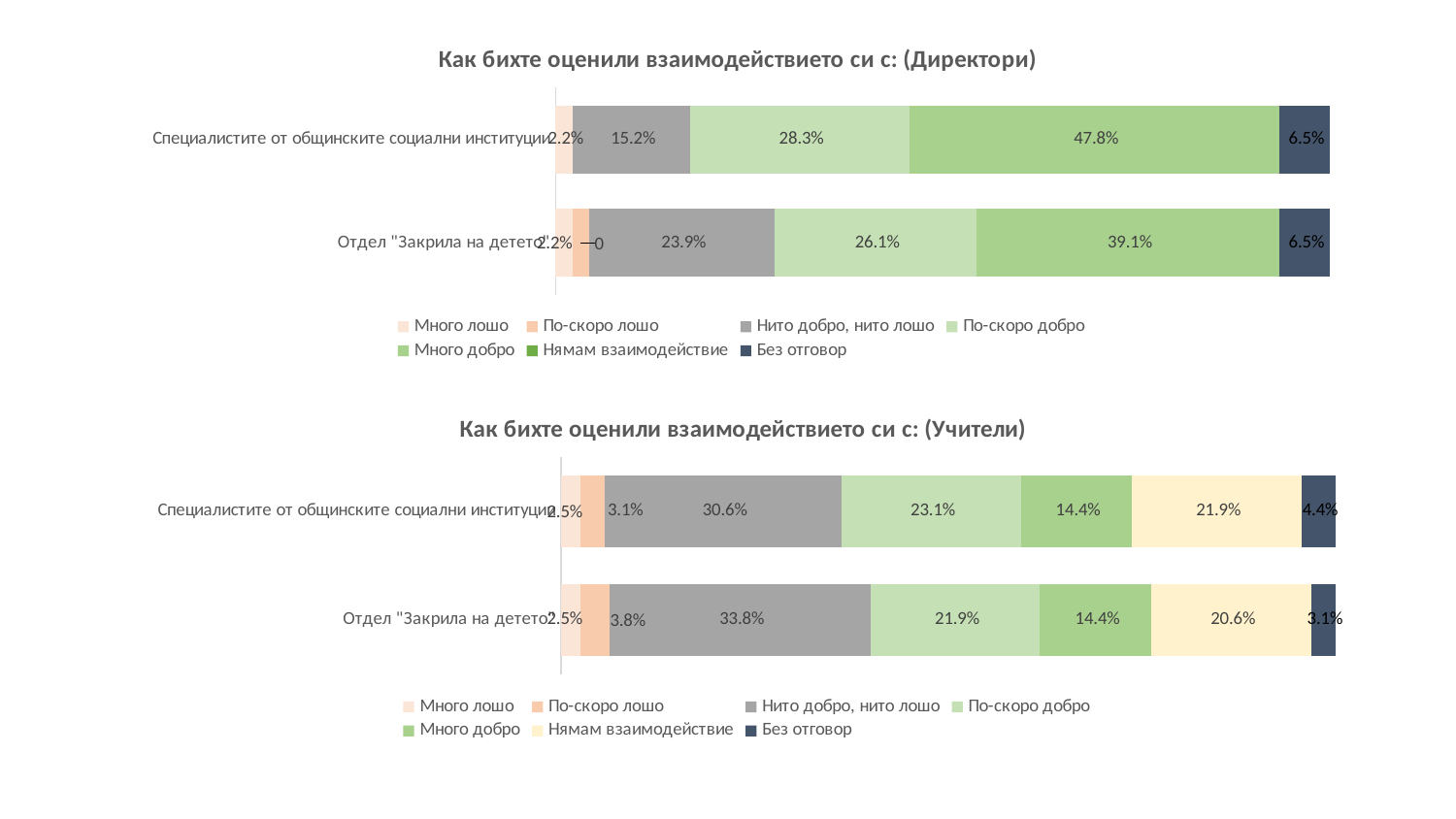
In the chart titled "Как бихте оценили взаимодействието си с: (Учители)", which series has the highest value for "Специалистите от общинските социални институции"? Нито добро, нито лошо In the chart titled "Как бихте оценили взаимодействието си с: (Учители)", what is the difference between the "Без отговор" values for the two categories? 1.3% In the chart titled "Как бихте оценили взаимодействието си с: (Директори)", what is the value of "Много добро" for "Специалистите от общинските социални институции"? 47.8% In the chart titled "Как бихте оценили взаимодействието си с: (Директори)", what is the difference between the "Много добро" values for the two categories? 8.7% In the chart titled "Как бихте оценили взаимодействието си с: (Директори)", what is the value of "Нито добро, нито лошо" for "Отдел "Закрила на детето""? 23.9% How many series does the legend of the chart titled "Как бихте оценили взаимодействието си с: (Учители)" list? 7 In the chart titled "Как бихте оценили взаимодействието си с: (Учители)", what is the value of "Нито добро, нито лошо" for "Отдел "Закрила на детето""? 33.8% How many categories are shown in the chart titled "Как бихте оценили взаимодействието си с: (Директори)"? 2 In the chart titled "Как бихте оценили взаимодействието си с: (Учители)", what is the value of "Нямам взаимодействие" for "Специалистите от общинските социални институции"? 21.9% What type of chart is the chart titled "Как бихте оценили взаимодействието си с: (Учители)"? Stacked bar chart In the chart titled "Как бихте оценили взаимодействието си с: (Директори)", what is the "Без отговор" value for "Отдел "Закрила на детето""? 6.5% In the chart titled "Как бихте оценили взаимодействието си с: (Директори)", which category has the larger "По-скоро добро" value? Специалистите от общинските социални институции